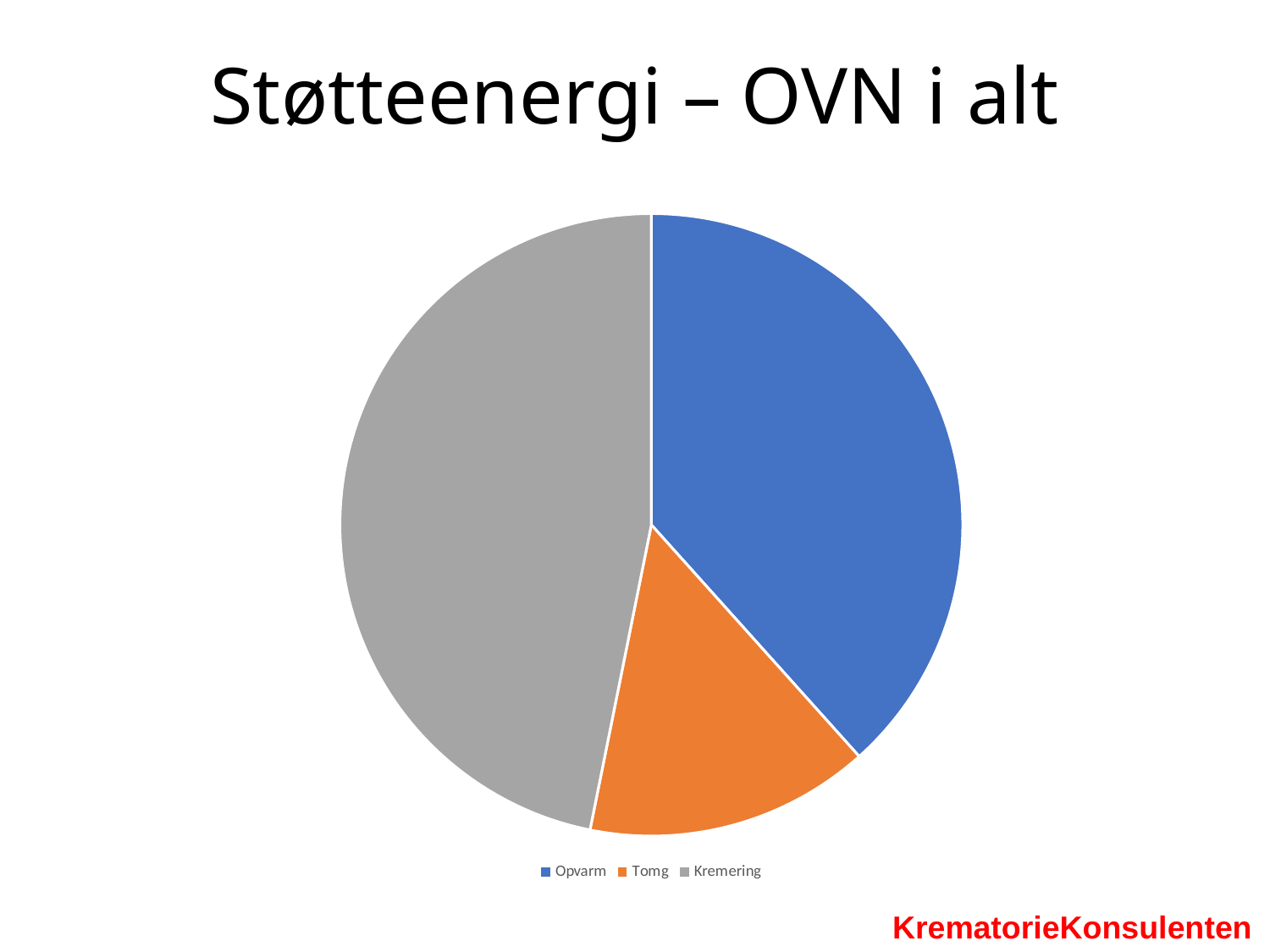
What kind of chart is shown on the slide? pie chart Which slice is larger, Kremering or Tomg? Kremering How many slices does the pie chart have? 3 How many entries does the legend of the pie chart list? 3 Which slice is larger, Kremering or Opvarm? Kremering Which category has the smallest slice of the pie chart? Tomg Which category has the largest slice of the pie chart? Kremering What colour is the Tomg slice in the pie chart? orange Which slice is larger, Opvarm or Tomg? Opvarm What is the title of the slide containing the pie chart? Støtteenergi – OVN i alt